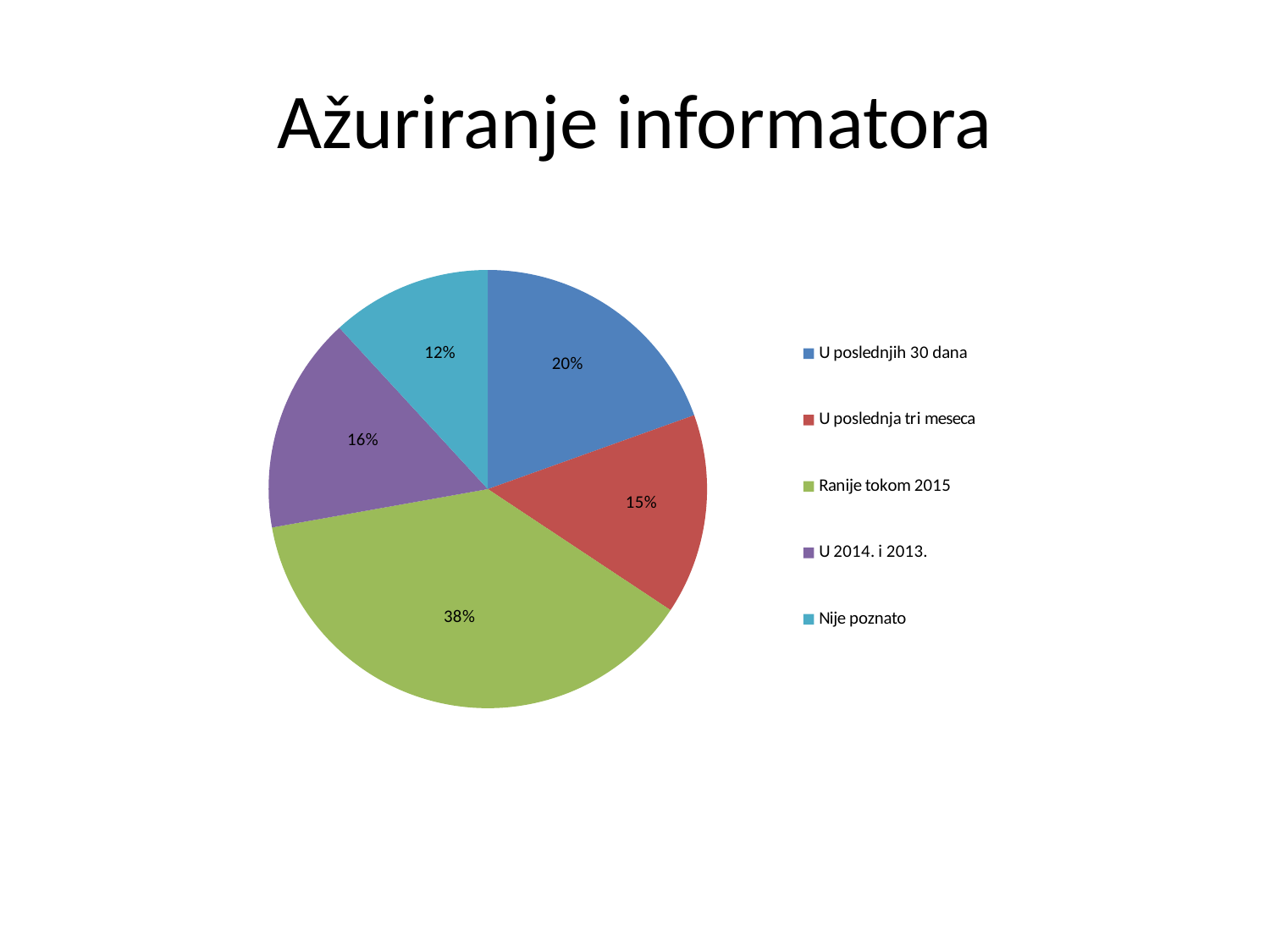
Which is larger, the share for "U poslednjih 30 dana" or the share for "U 2014. i 2013."? U poslednjih 30 dana What is the share for "U 2014. i 2013."? 16% How many categories does the pie chart have? 5 What is the share for "Nije poznato"? 12% What is the share for "Ranije tokom 2015"? 38% What kind of chart is shown on the slide? pie chart What is the title of the slide? Ažuriranje informatora What is the share for "U poslednjih 30 dana"? 20% Which category has the smallest slice of the pie? Nije poznato What is the share for "U poslednja tri meseca"? 15% Which category has the largest slice of the pie? Ranije tokom 2015 What is the difference between the shares of "Ranije tokom 2015" and "U poslednjih 30 dana"? 18%